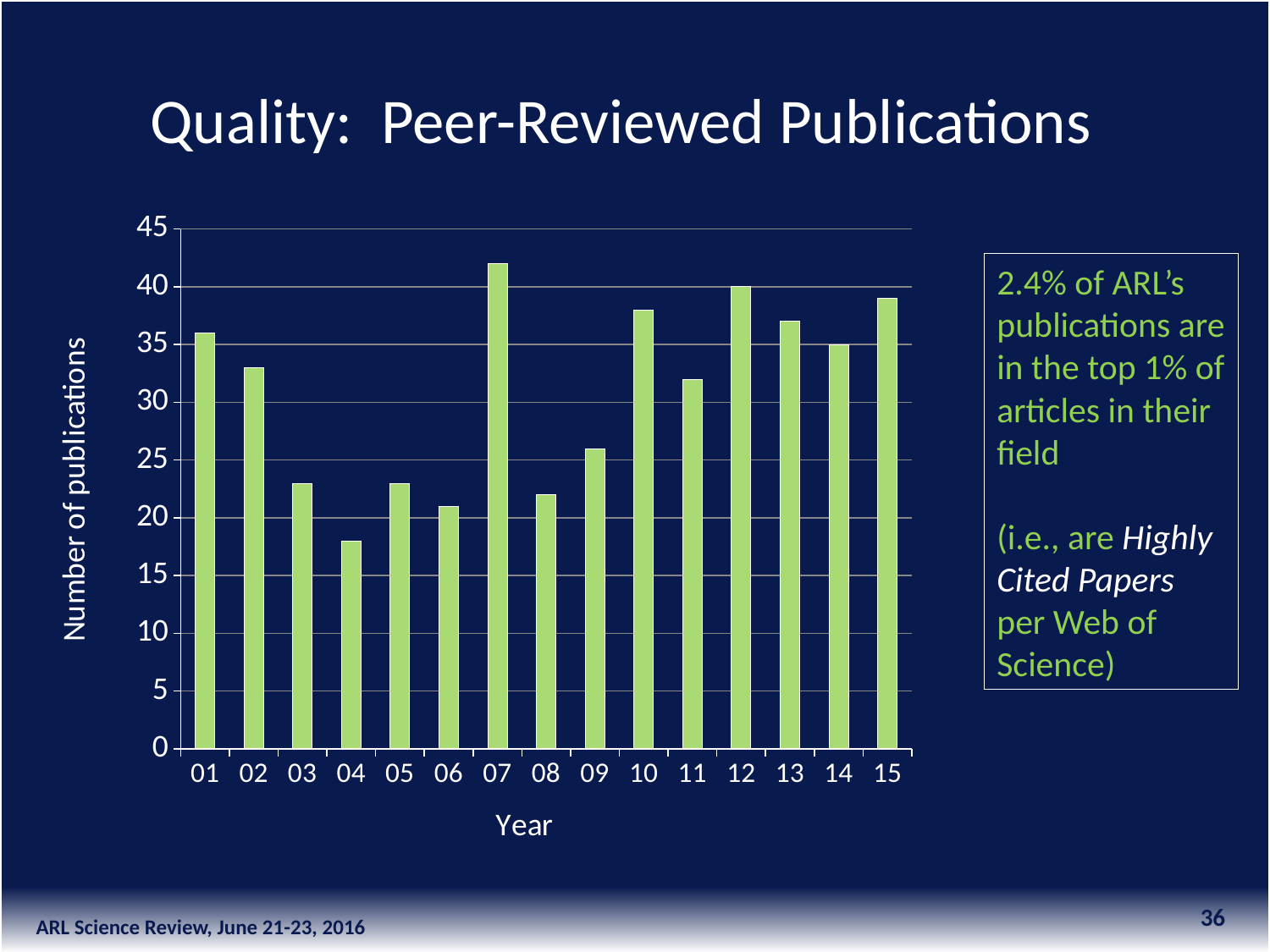
Which year has the lowest number of publications? 04 What kind of chart is shown on the slide? bar chart Is the number of publications for year 06 greater or less than 25? less Which year has more publications, 09 or 10? 10 Is the number of publications for year 10 greater or less than 35? greater What is the label of the x axis of the chart? Year Which year has the highest number of publications? 07 How many years are plotted on the x axis of the chart? 15 Is the number of publications for year 07 greater or less than 40? greater What is the label of the y axis of the chart? Number of publications Which year has more publications, 02 or 03? 02